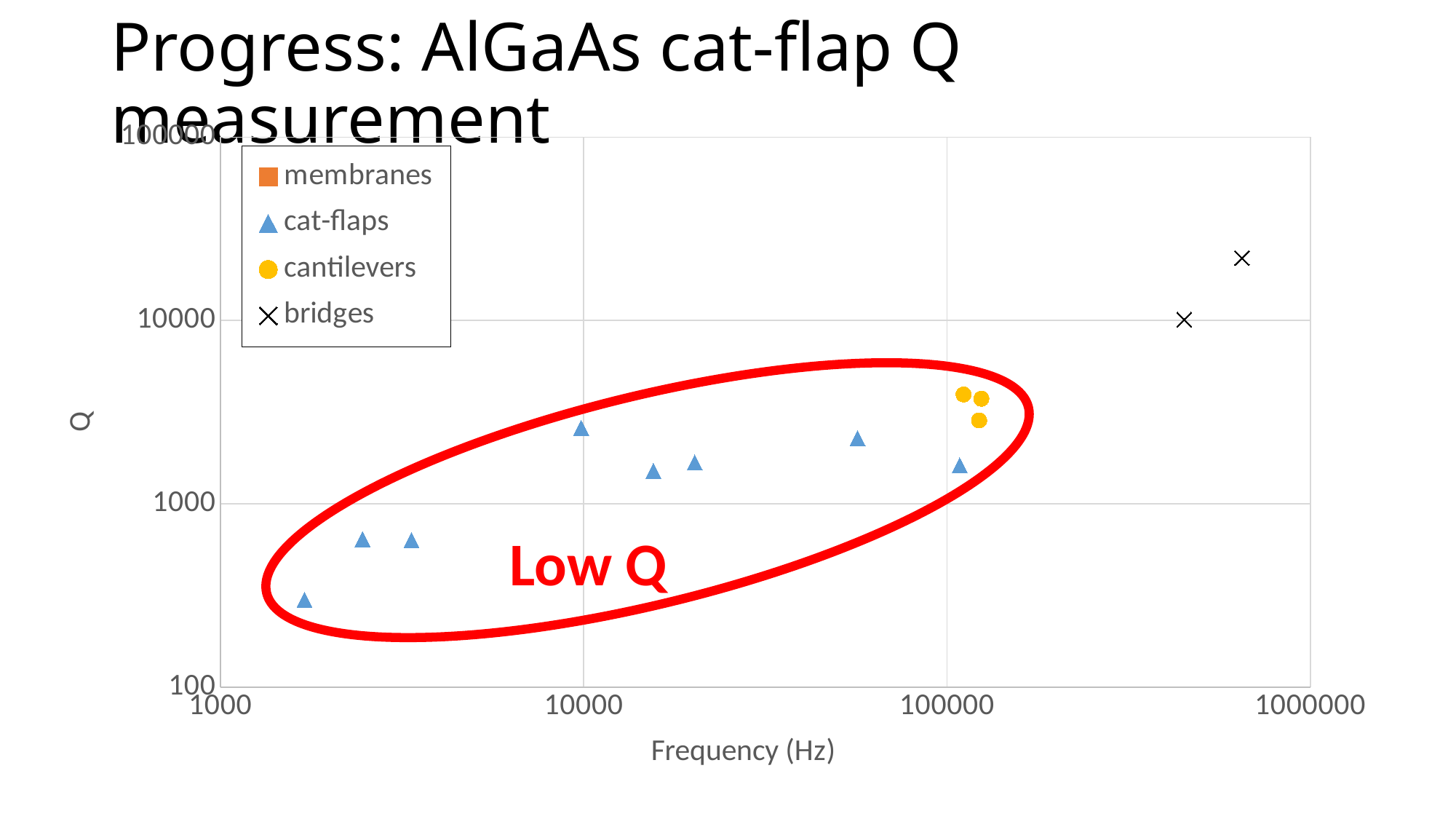
How many cat-flaps points are plotted on the chart? 8 Do the cat-flaps Q values generally rise or fall as frequency increases? rise What kind of chart is shown on the slide? scatter chart What is the label of the x axis? Frequency (Hz) Which series has the point with the lowest Q value? cat-flaps How many cantilevers points are plotted on the chart? 3 Which series has the point with the highest Q value? bridges Is the Q value of the cat-flaps point at the lowest frequency greater or less than 1000? less How many series does the legend list? 4 Is the Q value of the bridges point at the highest frequency greater or less than 10000? greater What text is written inside the red ellipse on the chart? Low Q How many bridges points are plotted on the chart? 2